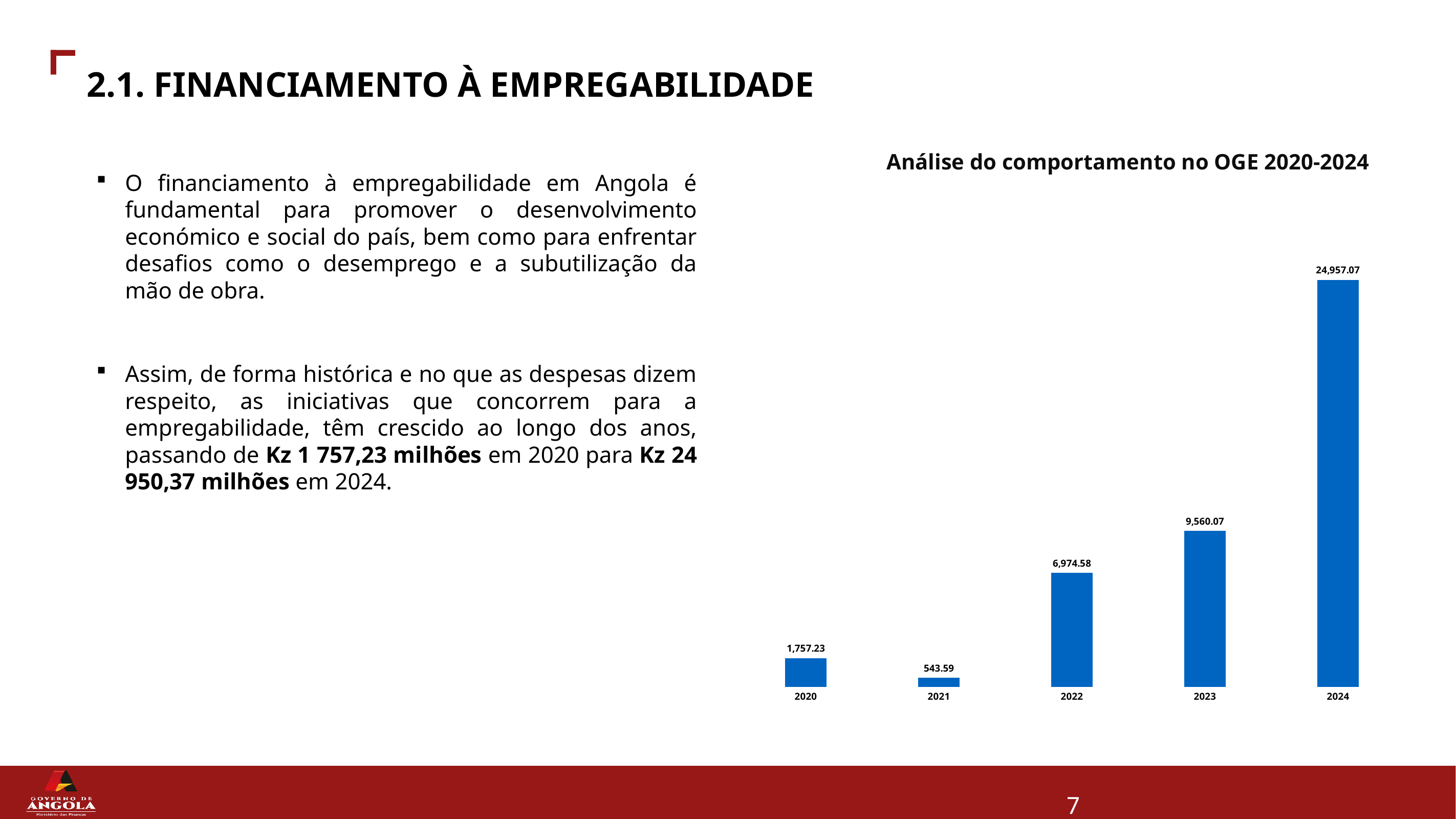
What is the value shown for 2021 in the chart? 543.59 What is the value shown for 2020 in the chart? 1,757.23 What is the title of the chart? Análise do comportamento no OGE 2020-2024 Which year has the highest value in the chart? 2024 Which is larger, the value for 2020 or the value for 2021? 2020 How many years are shown in the chart? 5 What kind of chart is shown on the slide? Bar chart What is the value shown for 2024 in the chart? 24,957.07 What is the difference between the values for 2022 and 2021? 6,430.99 Which year has the lowest value in the chart? 2021 What is the difference between the values for 2024 and 2023? 15,397.00 What is the value shown for 2022 in the chart? 6,974.58